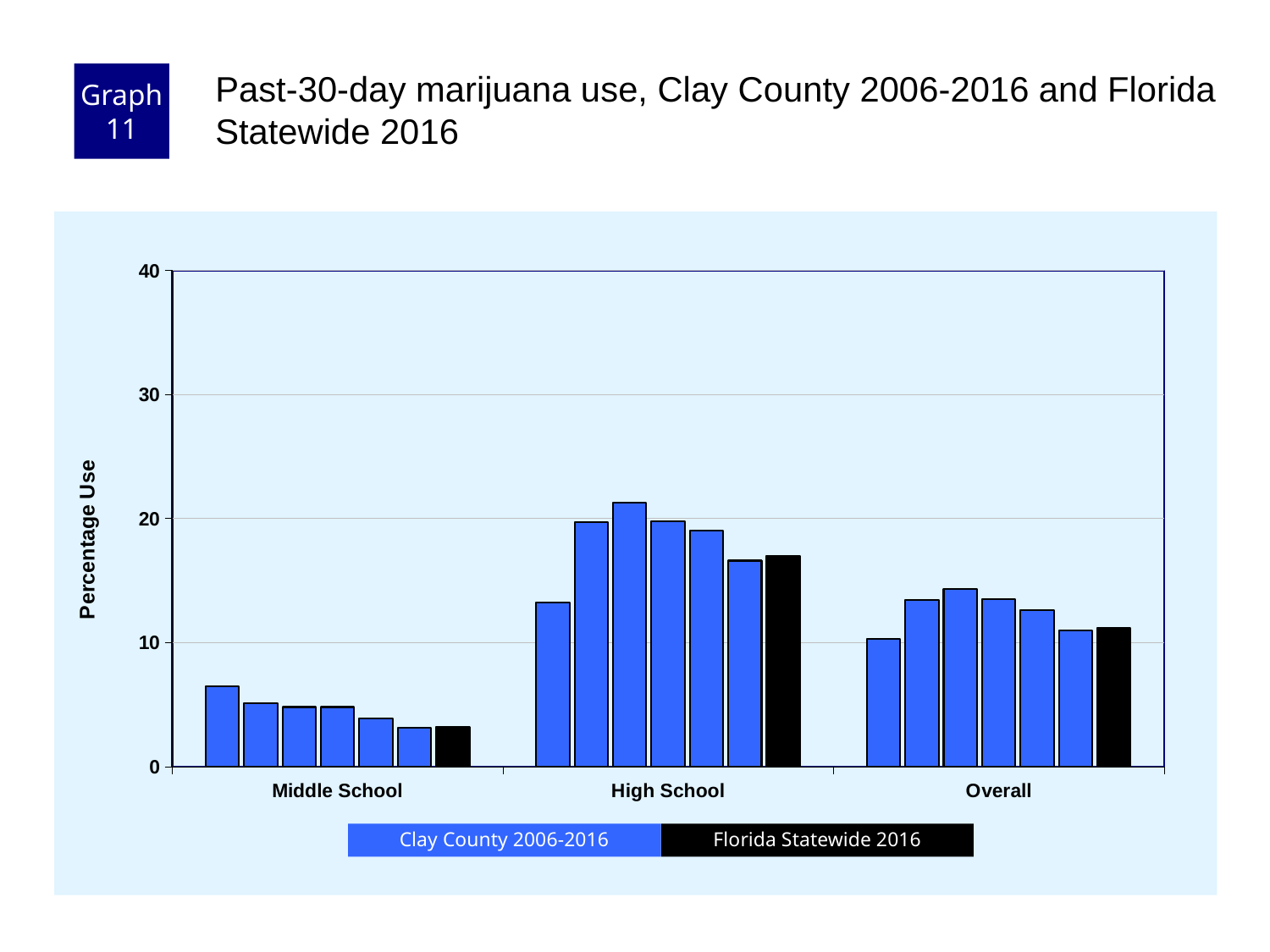
What kind of chart is shown on the slide? bar chart What is the label on the y axis? Percentage Use Which category has the highest bars overall? High School Which category has the lowest bars overall? Middle School Is the Florida Statewide 2016 value for Overall greater or less than 10? greater Which is larger, the Florida Statewide 2016 value for High School or for Overall? High School Is the Florida Statewide 2016 value for Middle School greater or less than 10? less How many series does the legend list? 2 How many school-level categories are shown on the x axis? 3 Is the Florida Statewide 2016 value for High School greater or less than 20? less What colour represents Florida Statewide 2016 in the legend? black